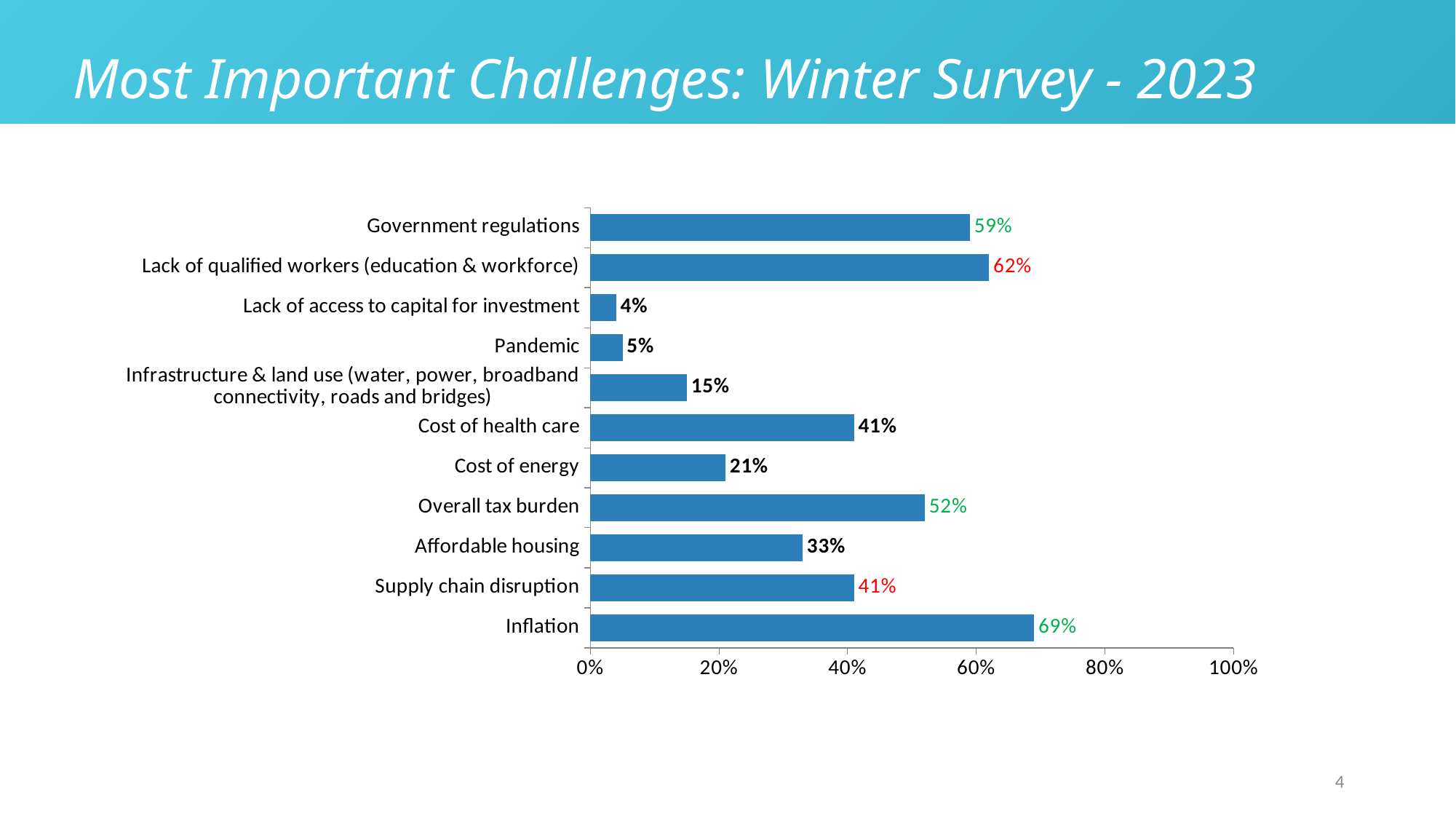
What kind of chart is shown on the slide? bar chart What is the value for Inflation? 69% Which is larger, the value for Overall tax burden or the value for Affordable housing? Overall tax burden Which category has the lowest value? Lack of access to capital for investment What is the difference between the values for Inflation and Government regulations? 10% Which category has the highest value? Inflation What is the value for Infrastructure & land use (water, power, broadband connectivity, roads and bridges)? 15% What is the value for Lack of qualified workers (education & workforce)? 62% How many categories are shown in the chart? 11 What is the value for Cost of energy? 21% Is the value for Cost of health care greater or less than 60%? less What is the title of the slide? Most Important Challenges: Winter Survey - 2023